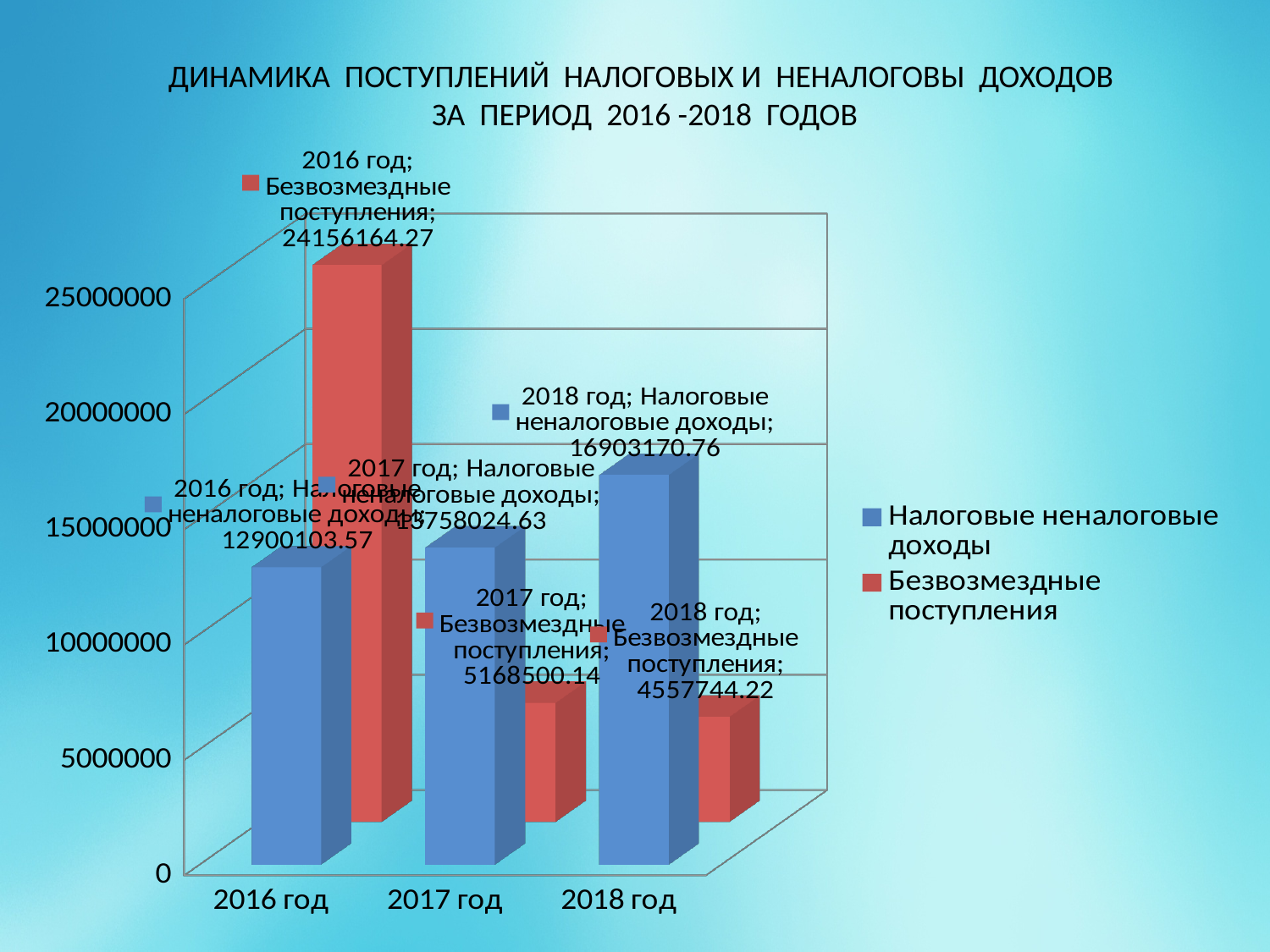
What is the value of Безвозмездные поступления for 2016 год? 24156164.27 What is the value of Налоговые неналоговые доходы for 2016 год? 12900103.57 What is the value of Безвозмездные поступления for 2018 год? 4557744.22 How many series does the legend list? 2 Do the values for Безвозмездные поступления rise or fall from 2016 год to 2018 год? fall In which year is Налоговые неналоговые доходы highest? 2018 год What kind of chart is shown on the slide? bar chart What is the value of Безвозмездные поступления for 2017 год? 5168500.14 In which year is Безвозмездные поступления highest? 2016 год What is the difference between Безвозмездные поступления in 2017 год and 2018 год? 610755.92 In 2016 год, which series has the larger value: Налоговые неналоговые доходы or Безвозмездные поступления? Безвозмездные поступления What is the value of Налоговые неналоговые доходы for 2018 год? 16903170.76